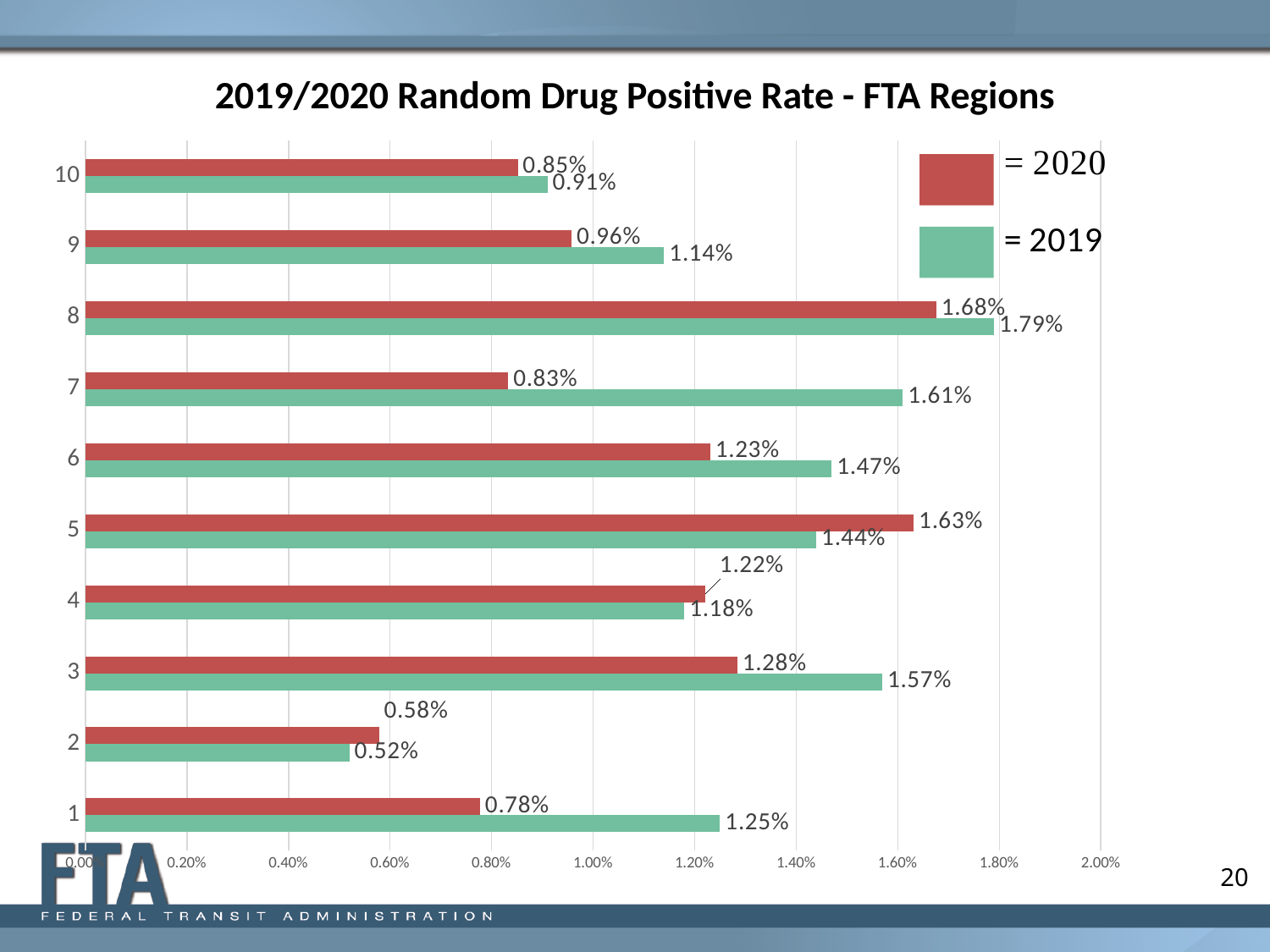
How many series does the legend list? 2 For Region 5, which year has the higher rate, 2019 or 2020? 2020 How many FTA regions are shown on the chart? 10 What is the 2019 random drug positive rate for Region 3? 1.57% Which region has the lowest 2019 random drug positive rate? Region 2 Which colour represents 2019 in the chart? Green What kind of chart is shown on the slide? Bar chart What is the difference between the 2019 and 2020 rates for Region 7? 0.78% Which region has the highest 2020 random drug positive rate? Region 8 What is the 2020 random drug positive rate for Region 7? 0.83% What is the 2020 value for Region 5? 1.63% Is the 2019 value for Region 8 greater or less than 1.60%? greater